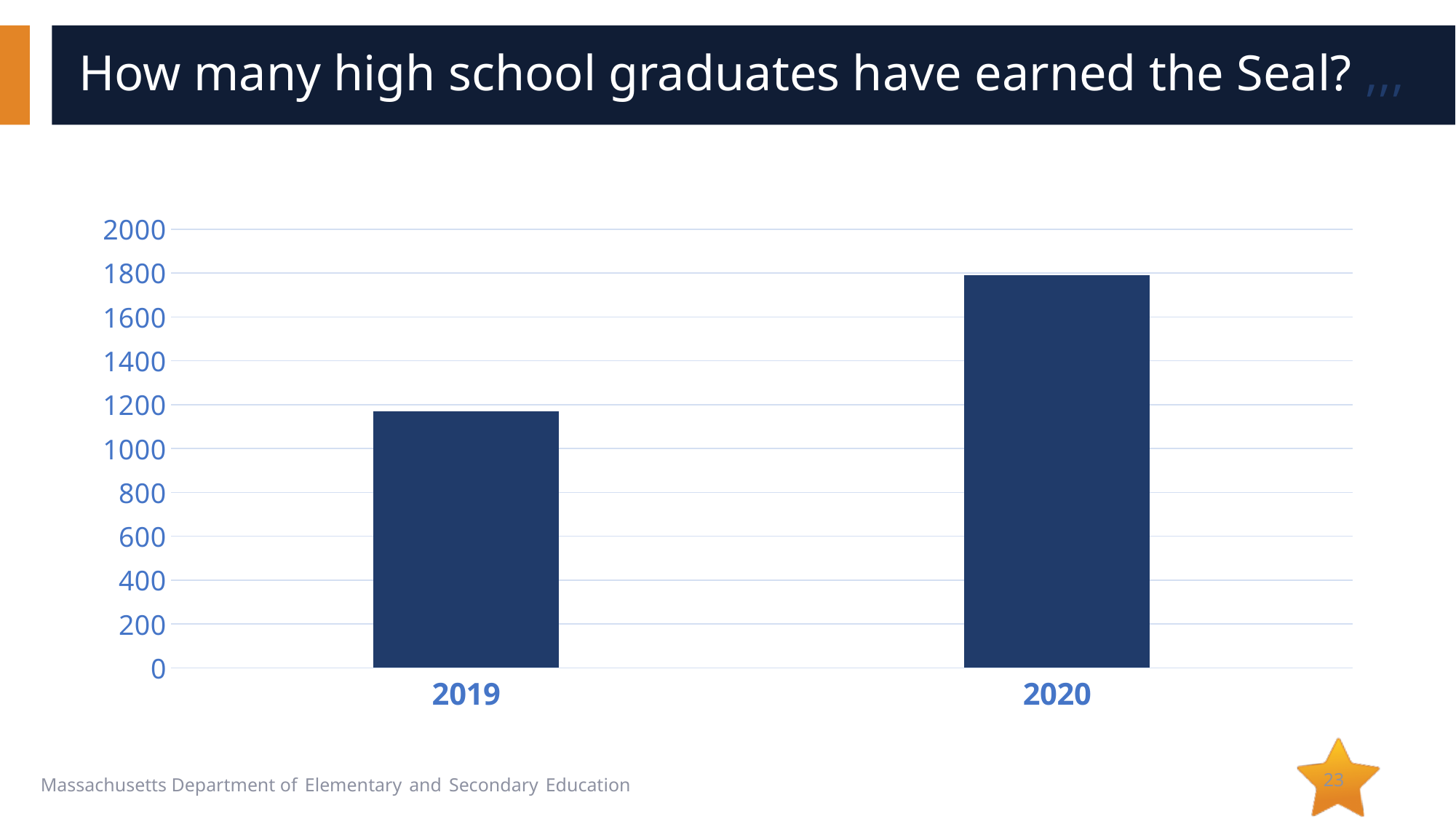
Which year has the lowest bar in the chart? 2019 Is the value for 2019 greater or less than 1000? greater How many bars (categories) does the chart show? 2 What is the maximum value shown on the chart's vertical axis? 2000 What is the title of the slide containing the chart? How many high school graduates have earned the Seal? Which is larger, the value for 2019 or the value for 2020? 2020 Which year has the highest bar in the chart? 2020 What kind of chart is shown on the slide? bar chart Is the value for 2020 greater or less than 2000? less Is the value for 2019 greater or less than 1400? less Do the values rise or fall from 2019 to 2020? rise